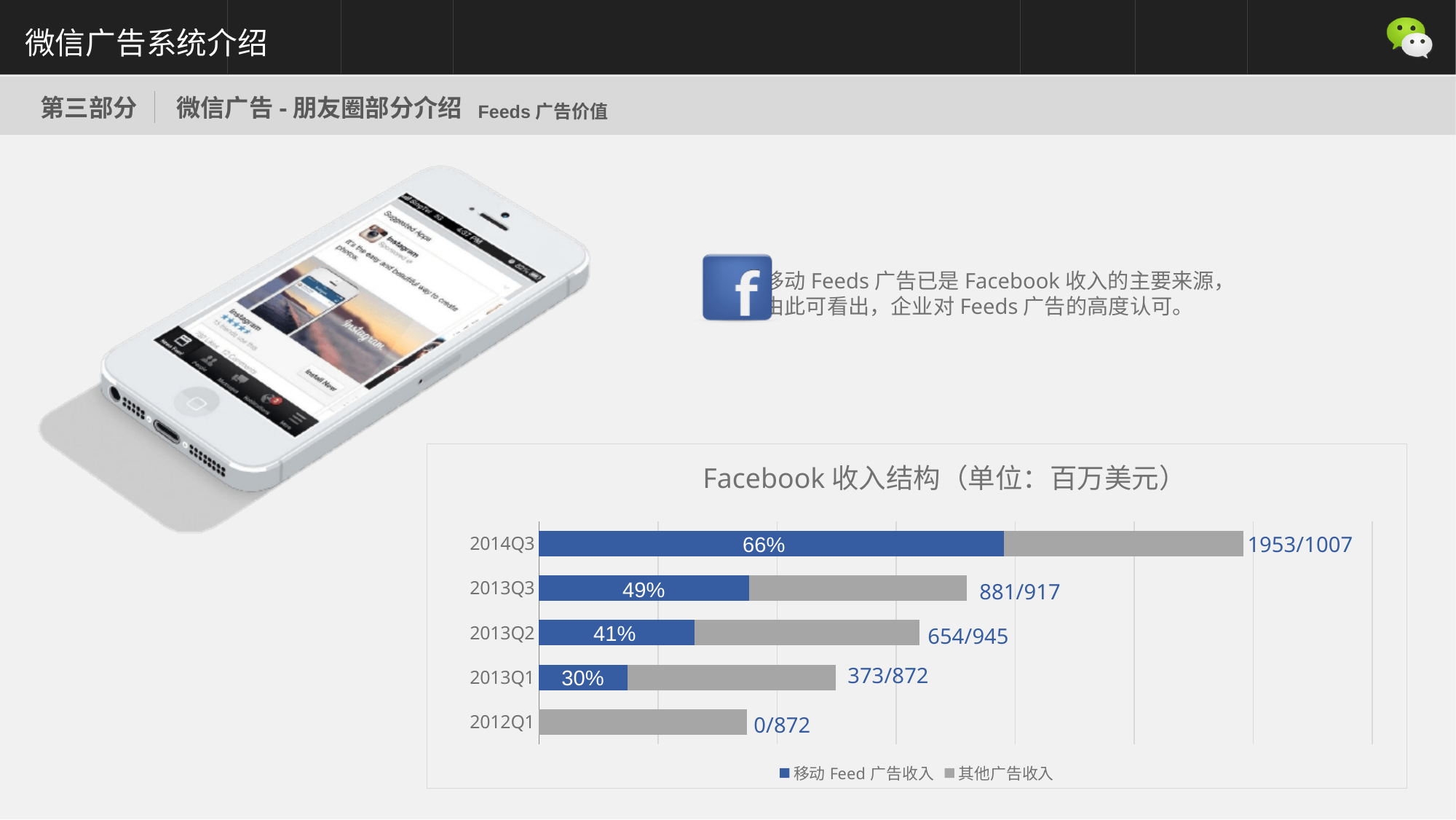
What is the title of the chart? Facebook 收入结构（单位：百万美元） What is the 移动 Feed 广告收入 value for 2012Q1? 0 How many quarters (categories) are shown in the chart? 5 What is the data label shown at the end of the 2013Q2 bar? 654/945 What percentage label is shown on the 移动 Feed 广告收入 bar for 2014Q3? 66% What percentage label is shown on the 移动 Feed 广告收入 bar for 2013Q1? 30% Which quarter has the highest 移动 Feed 广告收入? 2014Q3 What is the total of the stacked bar for 2013Q1 (移动 Feed 广告收入 plus 其他广告收入)? 1245 What is the difference between 移动 Feed 广告收入 in 2014Q3 and 2013Q3? 1072 How many series does the chart legend list? 2 What kind of chart is shown on the slide? stacked bar chart Which quarter has the lowest 移动 Feed 广告收入? 2012Q1